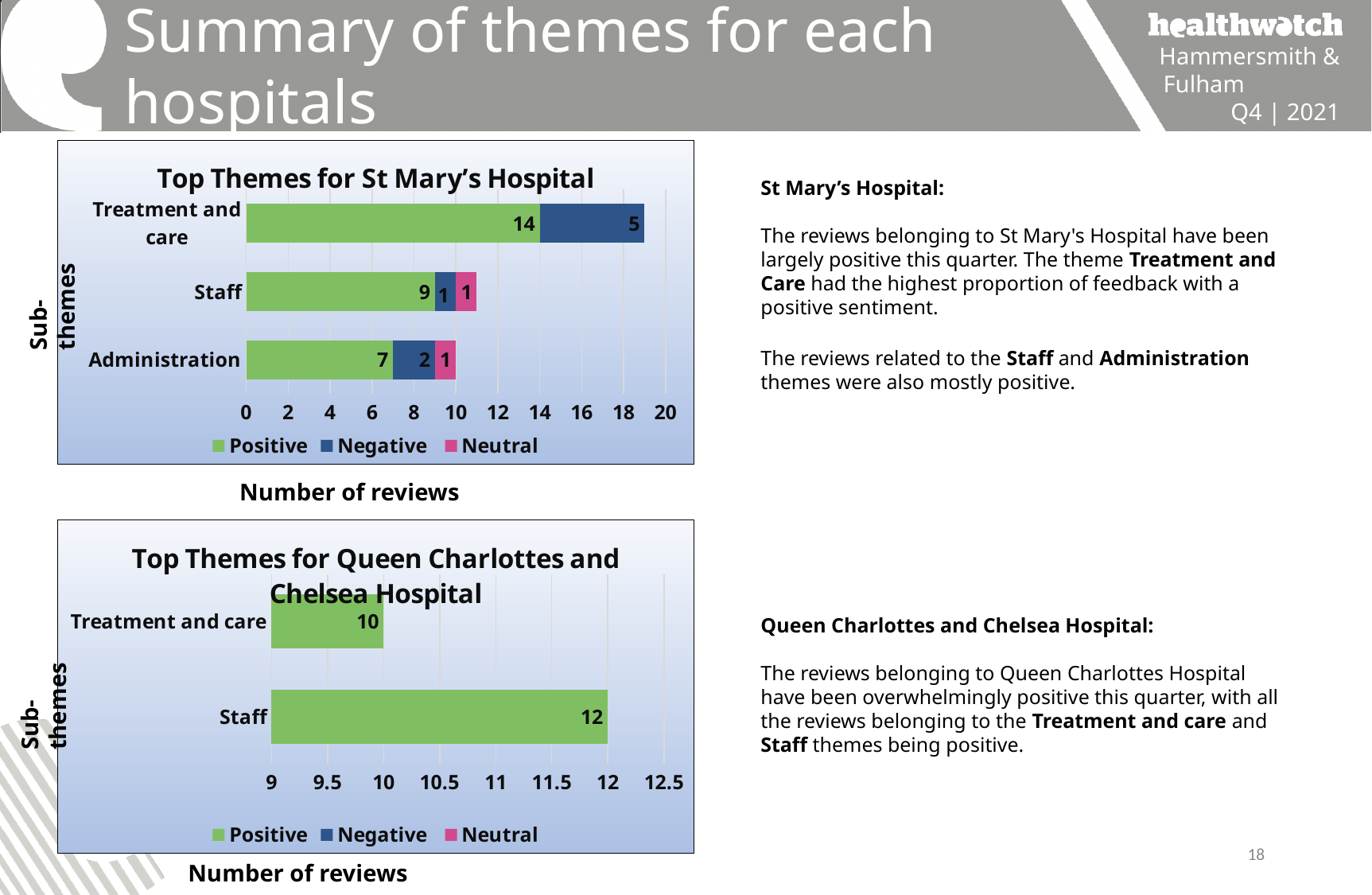
In the 'Top Themes for St Mary's Hospital' chart, what is the Positive value for Treatment and care? 14 In the 'Top Themes for St Mary's Hospital' chart, which sub-theme has the highest Positive value? Treatment and care In the 'Top Themes for St Mary's Hospital' chart, what is the Negative value for Administration? 2 In the 'Top Themes for Queen Charlottes and Chelsea Hospital' chart, what is the Positive value for Staff? 12 What kind of chart is 'Top Themes for St Mary's Hospital'? Stacked bar chart In the 'Top Themes for St Mary's Hospital' chart, what is the total of the stacked bar for Administration? 10 In the 'Top Themes for St Mary's Hospital' chart, which sub-theme has the lowest Positive value? Administration In the 'Top Themes for Queen Charlottes and Chelsea Hospital' chart, which is larger, the Positive value for Staff or for Treatment and care? Staff In the 'Top Themes for Queen Charlottes and Chelsea Hospital' chart, how many sub-themes are shown? 2 In the 'Top Themes for St Mary's Hospital' chart, what is the difference between the Positive values for Treatment and care and Staff? 5 In the 'Top Themes for St Mary's Hospital' chart, how many series does the legend list? 3 In the 'Top Themes for St Mary's Hospital' chart, what is the Neutral value for Staff? 1